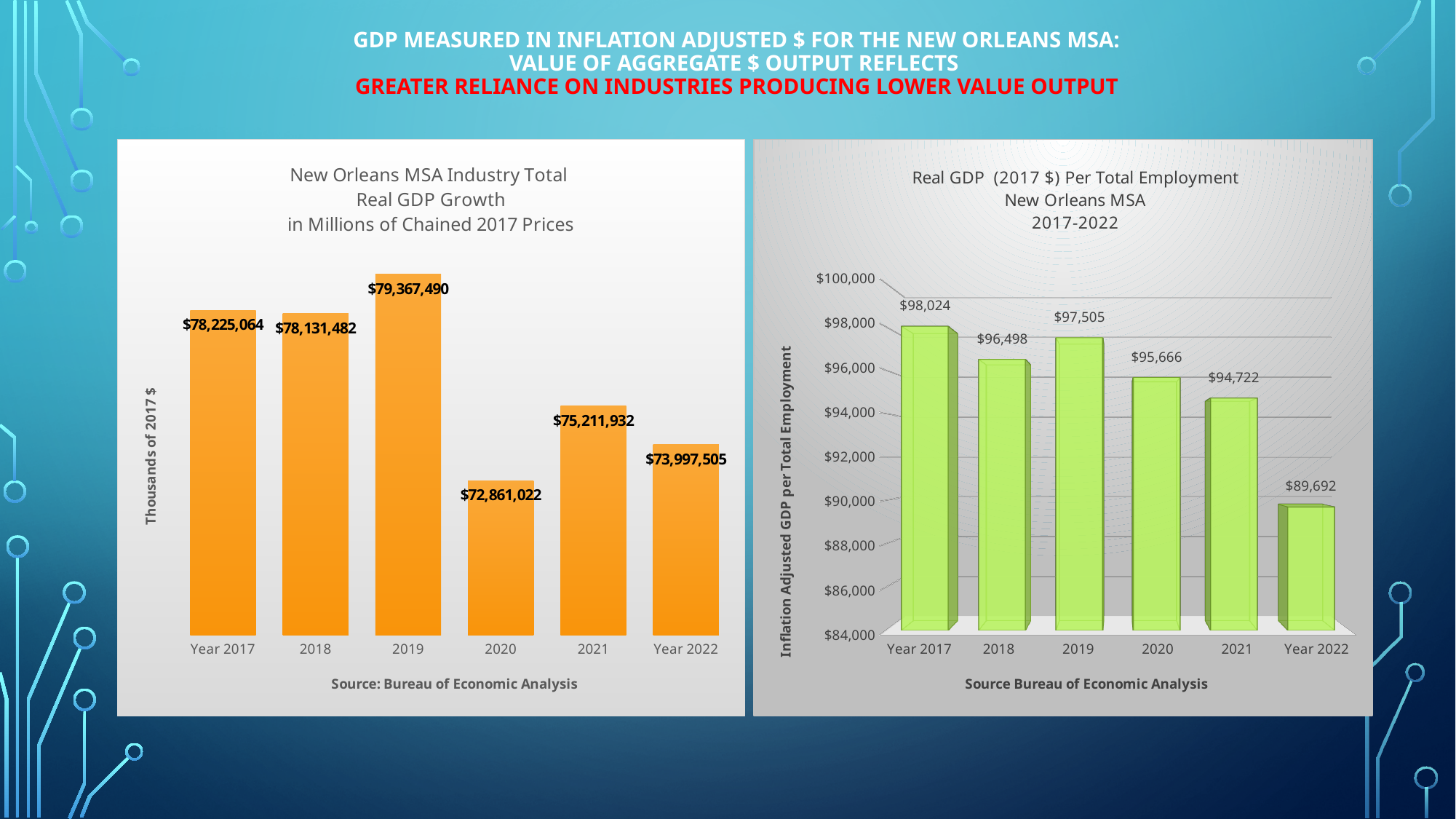
In the left chart (New Orleans MSA Industry Total Real GDP Growth), which year has the lowest value? 2020 In the left chart (New Orleans MSA Industry Total Real GDP Growth), what is the value for 2019? $79,367,490 In the left chart (New Orleans MSA Industry Total Real GDP Growth), how many years are plotted? 6 In the right chart (Real GDP (2017 $) Per Total Employment), is the value for 2021 greater or less than $96,000? less What is the y-axis label of the right chart (Real GDP (2017 $) Per Total Employment)? Inflation Adjusted GDP per Total Employment In the left chart (New Orleans MSA Industry Total Real GDP Growth), which year has the highest value? 2019 In the left chart (New Orleans MSA Industry Total Real GDP Growth), what is the difference between the 2019 and 2020 values? $6,506,468 In the right chart (Real GDP (2017 $) Per Total Employment), which year has the highest value? Year 2017 In the right chart (Real GDP (2017 $) Per Total Employment), what is the difference between the Year 2017 and Year 2022 values? $8,332 What kind of chart is the right chart (Real GDP (2017 $) Per Total Employment)? Bar chart In the right chart (Real GDP (2017 $) Per Total Employment), which is larger, the value for 2018 or the value for 2019? 2019 In the right chart (Real GDP (2017 $) Per Total Employment), what is the value for Year 2022? $89,692